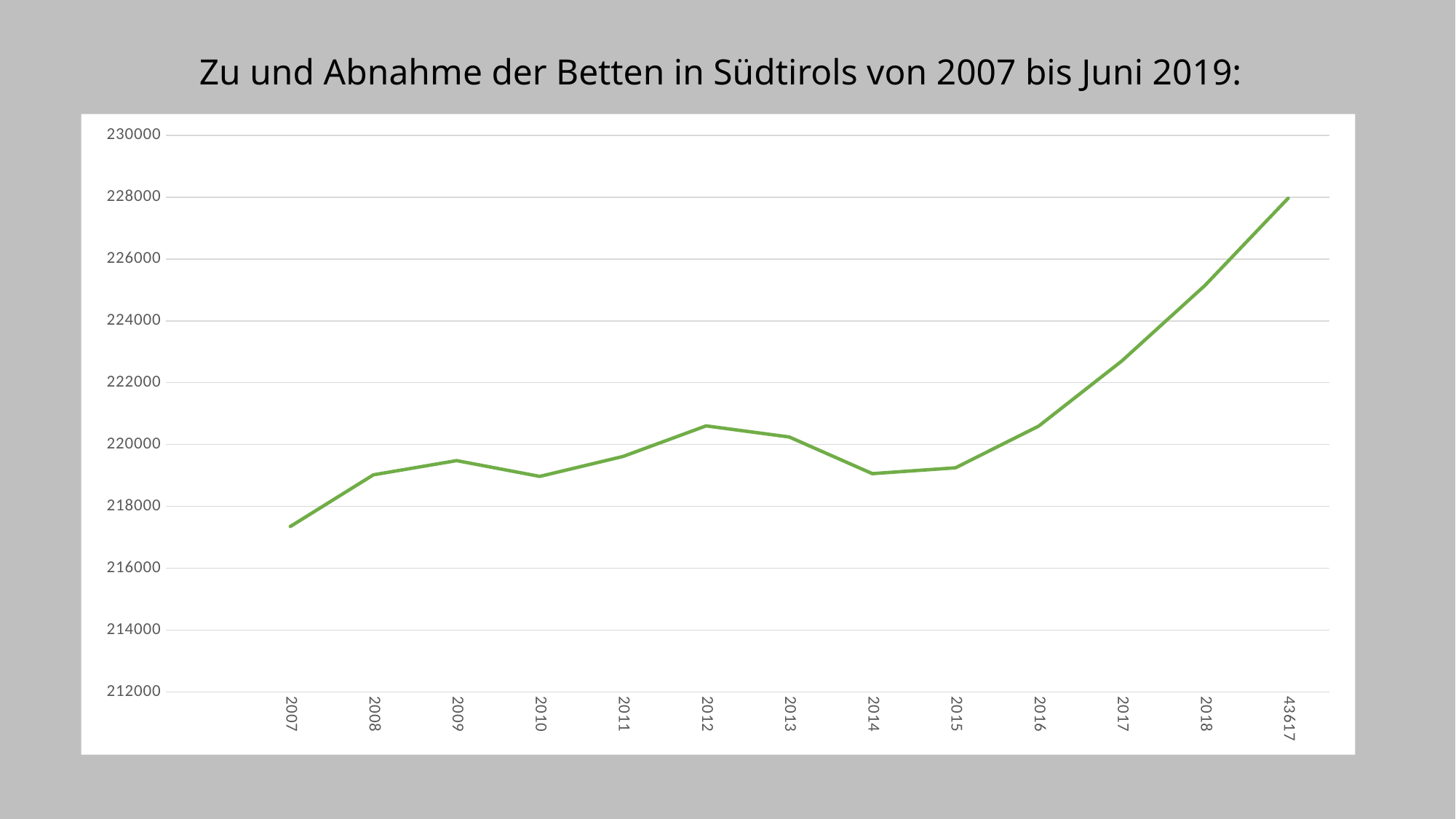
Which x-axis category has the highest value? 43617 Is the value for 2012 greater or less than 220000? greater Which has the larger value, 2008 or 2018? 2018 Which has the larger value, 2012 or 2014? 2012 Is the value for 2014 greater or less than 220000? less How many data points are plotted on the line? 13 Overall, do the values rise or fall from 2007 to the last point on the x axis? rise Which year has the lowest value? 2007 What is the title of the chart? Zu und Abnahme der Betten in Südtirols von 2007 bis Juni 2019: Is the value for 2018 greater or less than 224000? greater What kind of chart is shown on the slide? line chart